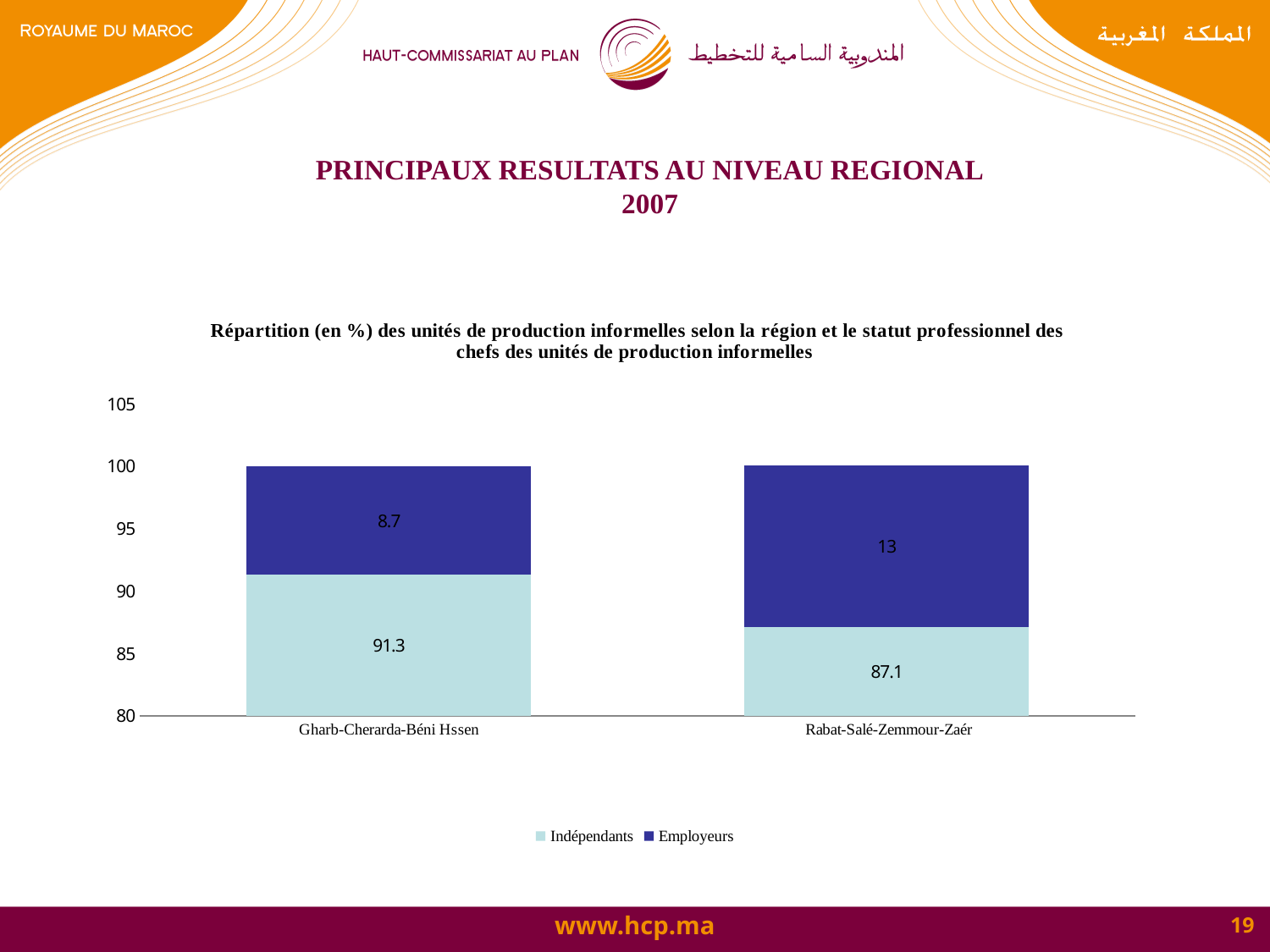
How many regions are shown on the x axis? 2 What kind of chart is shown? stacked bar chart Which region has the lower value for Indépendants? Rabat-Salé-Zemmour-Zaér What is the value for Employeurs in Rabat-Salé-Zemmour-Zaér? 13 What is the value for Indépendants in Rabat-Salé-Zemmour-Zaér? 87.1 What is the value for Indépendants in Gharb-Cherarda-Béni Hssen? 91.3 What is the value for Employeurs in Gharb-Cherarda-Béni Hssen? 8.7 Is the Indépendants value for Gharb-Cherarda-Béni Hssen larger or smaller than the Indépendants value for Rabat-Salé-Zemmour-Zaér? larger How many series does the legend list? 2 What is the difference between the Employeurs values for Rabat-Salé-Zemmour-Zaér and Gharb-Cherarda-Béni Hssen? 4.3 What is the difference between the Indépendants values for Gharb-Cherarda-Béni Hssen and Rabat-Salé-Zemmour-Zaér? 4.2 Which region has the higher value for Employeurs? Rabat-Salé-Zemmour-Zaér